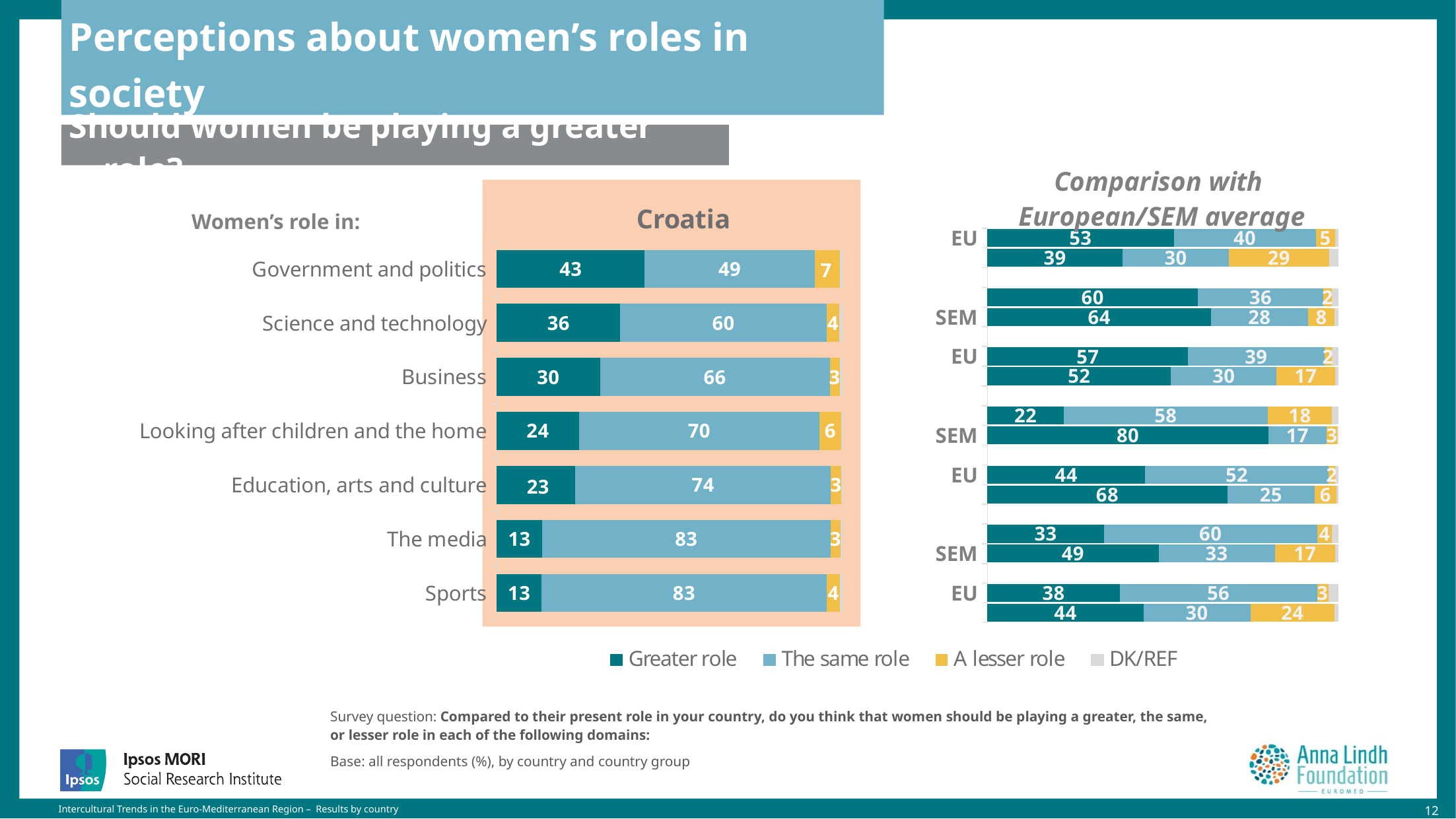
In the Croatia chart, what is the 'A lesser role' value for Sports? 4 How many domains are listed in the Croatia chart? 7 In the Croatia chart, which domain has the highest 'Greater role' value? Government and politics In the Croatia chart, which has a larger 'Greater role' value: Business or Education, arts and culture? Business In the Croatia chart, what percentage say women should play a greater role in Government and politics? 43 How many series does the legend list? 4 In the Croatia chart, what is the value for 'The same role' in Business? 66 In the Croatia chart, what is the value for 'A lesser role' in Looking after children and the home? 6 In the Croatia chart, what is the difference between the 'Greater role' values for Government and politics and Science and technology? 7 In the Croatia chart, which domain has the lowest 'The same role' value? Government and politics What type of chart is the Croatia chart? Stacked bar chart In the Croatia chart, do the 'Greater role' values rise or fall going down the list from Government and politics to Sports? Fall